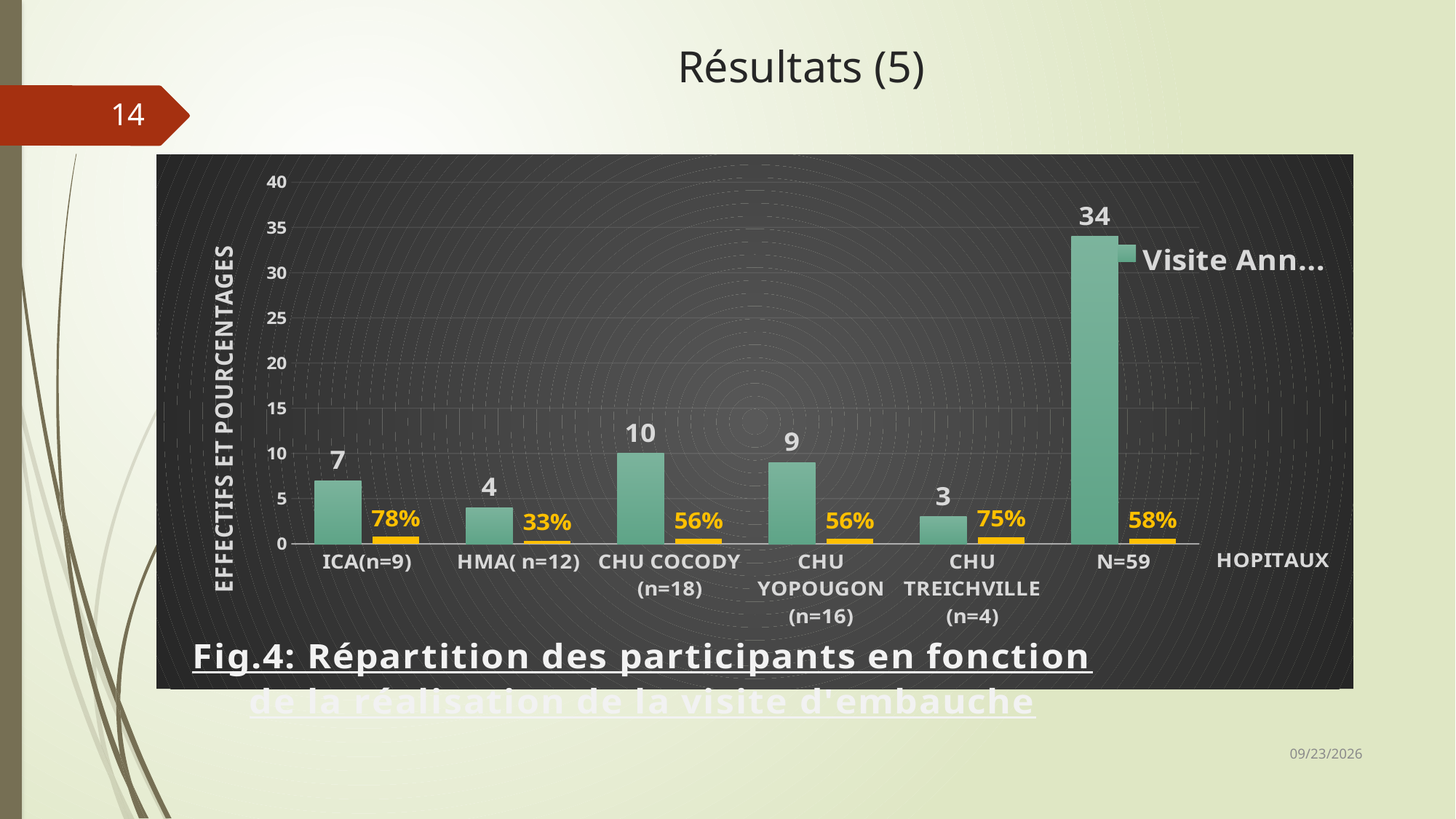
What percentage is shown for ICA(n=9)? 78% Which category has the highest green bar value? N=59 Which is larger, the green bar value for ICA(n=9) or for HMA( n=12)? ICA(n=9) What is the value of the green bar for CHU TREICHVILLE (n=4)? 3 What kind of chart is shown on the slide? bar chart What is the number of participants (green bar) for CHU COCODY (n=18)? 10 What percentage is shown for HMA( n=12)? 33% What is the y-axis title of the chart? EFFECTIFS ET POURCENTAGES What is the percentage shown for N=59? 58% Which hospital has the lowest percentage label? HMA( n=12) How many categories are shown on the x axis of the chart? 6 What is the difference between the green bar values for CHU COCODY (n=18) and CHU YOPOUGON (n=16)? 1